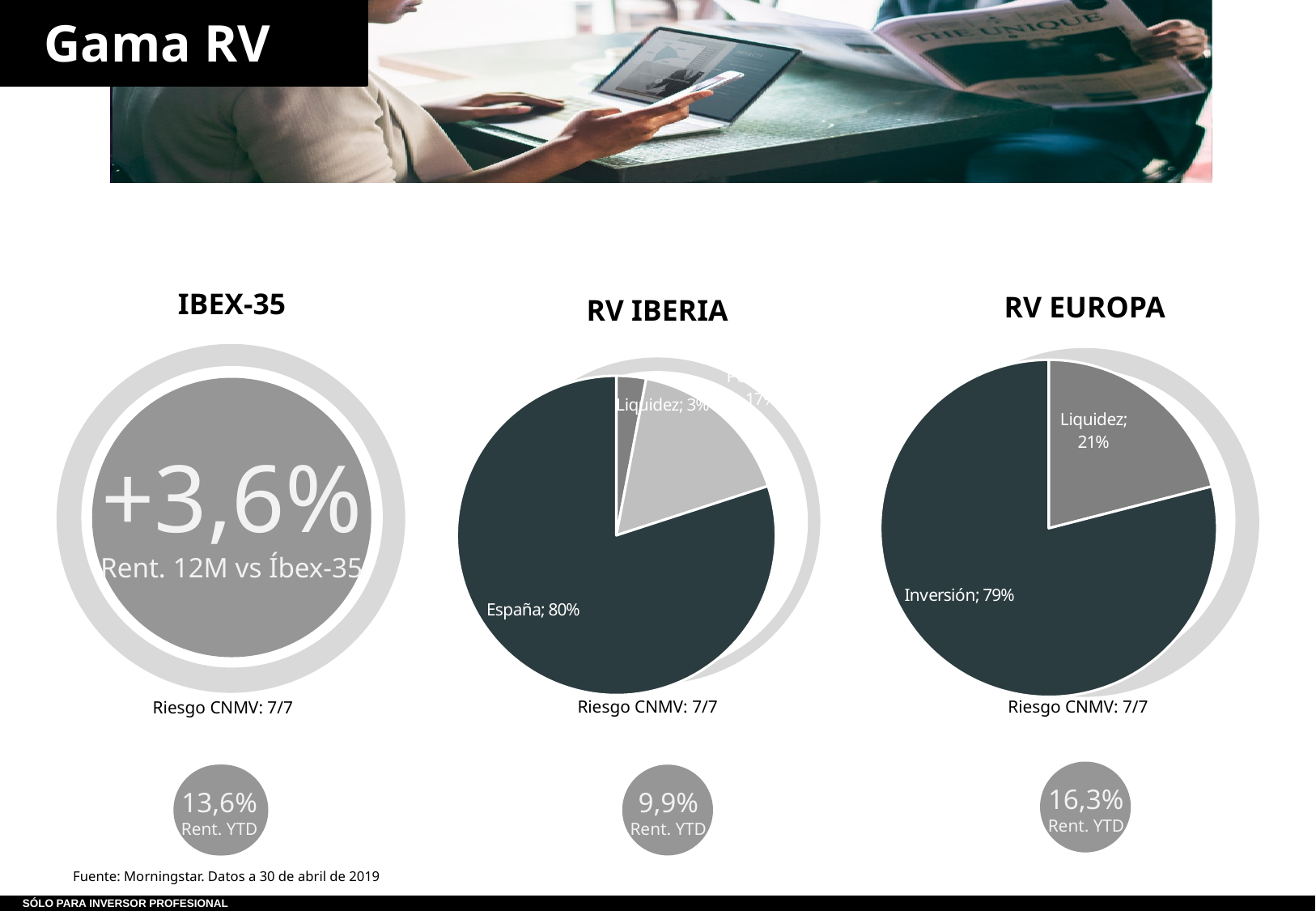
In the RV IBERIA chart, what share does Liquidez have? 3% How many slices does the RV IBERIA chart have? 3 In the RV IBERIA chart, which slice is the smallest? Liquidez Which is larger: the Liquidez share in the RV IBERIA chart or the Liquidez share in the RV EUROPA chart? RV EUROPA What kind of chart is the RV EUROPA chart? Pie chart In the RV EUROPA chart, which slice is the largest? Inversión In the RV EUROPA chart, what is the difference between the Inversión and Liquidez shares? 58% In the RV EUROPA chart, what share does Inversión have? 79% In the RV IBERIA chart, what share does España have? 80% In the RV EUROPA chart, what share does Liquidez have? 21% How many slices does the RV EUROPA chart have? 2 In the RV IBERIA chart, is the España share greater or less than 50%? greater